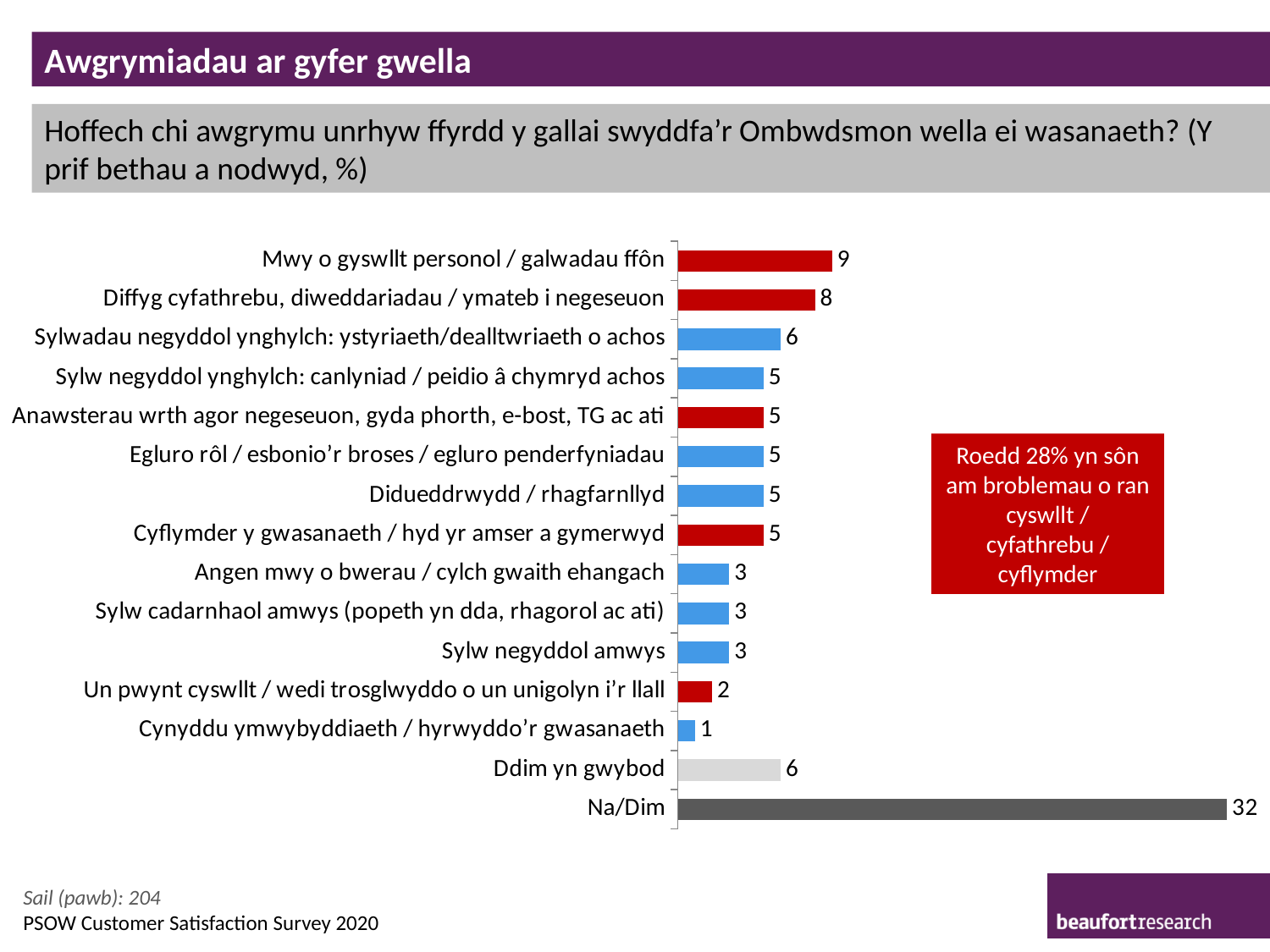
What is the value for "Un pwynt cyswllt / wedi trosglwyddo o un unigolyn i'r llall"? 2 What is the value for "Na/Dim"? 32 What is the difference between the values for "Mwy o gyswllt personol / galwadau ffôn" and "Diffyg cyfathrebu, diweddariadau / ymateb i negeseuon"? 1 Which is larger: the value for "Diffyg cyfathrebu, diweddariadau / ymateb i negeseuon" or the value for "Sylwadau negyddol ynghylch: ystyriaeth/dealltwriaeth o achos"? Diffyg cyfathrebu, diweddariadau / ymateb i negeseuon What type of chart is shown on the slide? Bar chart Which category has the highest value? Na/Dim What is the value for "Mwy o gyswllt personol / galwadau ffôn"? 9 How many categories are plotted in the chart? 15 What is the value for "Ddim yn gwybod"? 6 What percentage does the red call-out box say mentioned problems regarding contact / communication / speed? 28% What is the difference between the values for "Na/Dim" and "Mwy o gyswllt personol / galwadau ffôn"? 23 Which category has the lowest value? Cynyddu ymwybyddiaeth / hyrwyddo'r gwasanaeth